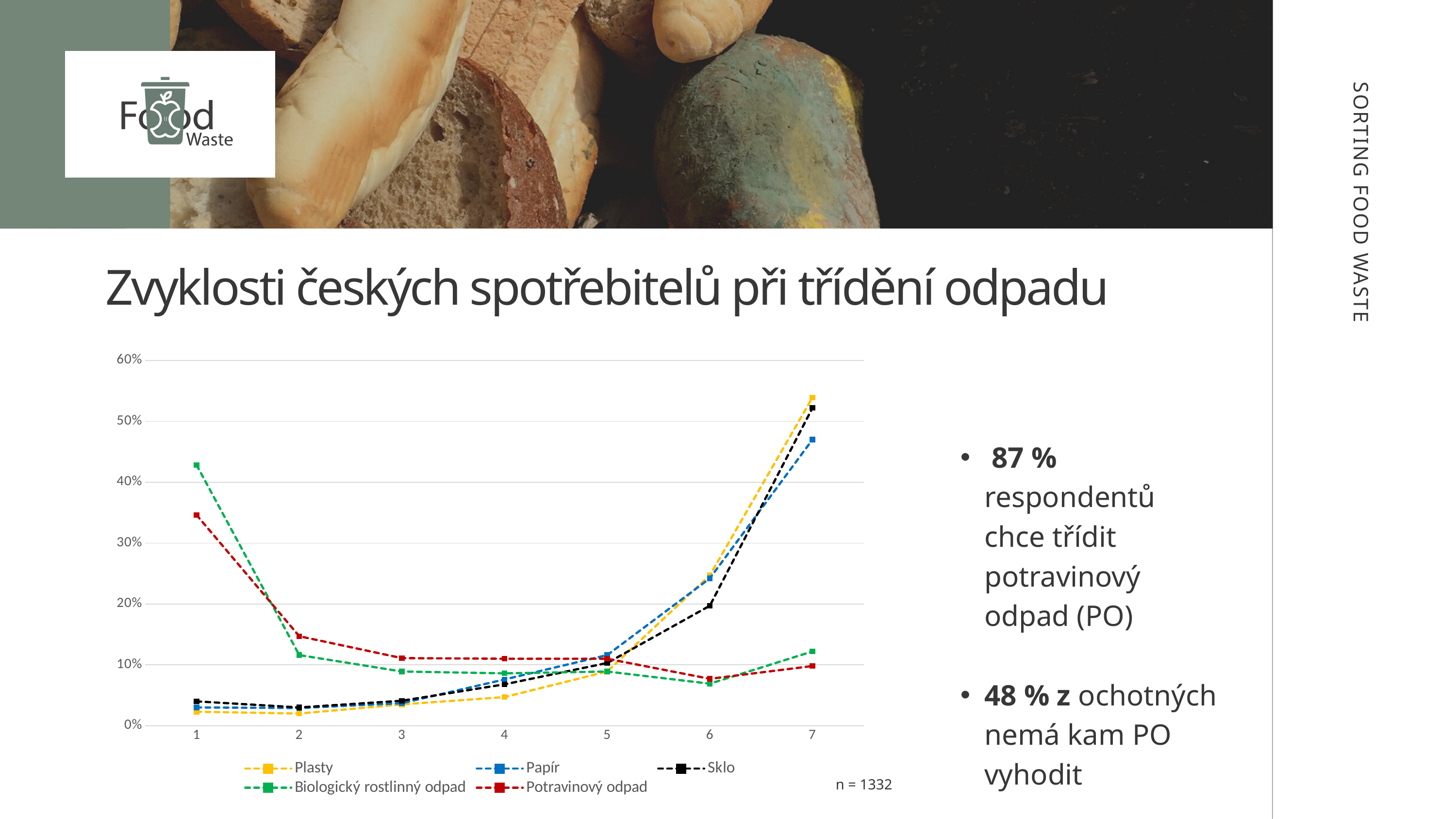
How many series does the chart legend list? 5 What kind of chart is shown on the slide? line chart How many points are there along the x axis of the chart? 7 What sample size (n) is stated below the chart? n = 1332 Is the value for Biologický rostlinný odpad at x = 1 greater or less than 40%? greater Is the value for Potravinový odpad at x = 1 greater or less than 30%? greater At x = 7, which is larger: Plasty or Papír? Plasty Is the value for Papír at x = 7 greater or less than 50%? less Which series has the highest value at x = 1? Biologický rostlinný odpad At x = 6, which is larger: Papír or Sklo? Papír Does the Plasty series rise or fall from x = 1 to x = 7? rise